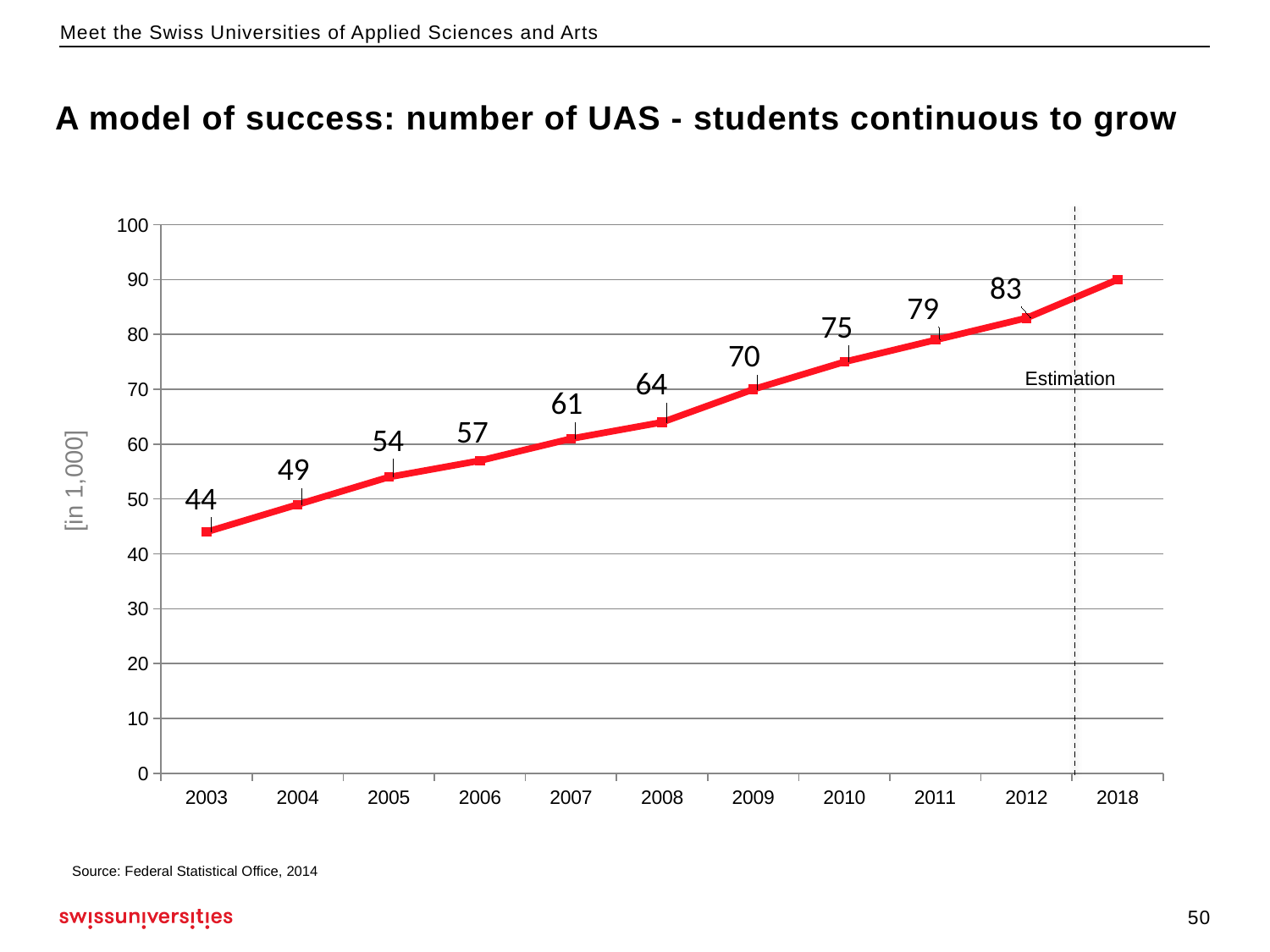
What is the value for 2009? 70 What is the value for 2012? 83 What is the difference between the values for 2012 and 2003? 39 What is the y-axis label? [in 1,000] Do the values rise or fall from 2003 to 2012? rise Is the value for 2018 greater or less than 80? greater What kind of chart is this? line chart What is the value for 2003? 44 How many years are shown on the x axis? 11 What is the difference between the values for 2008 and 2007? 3 Which labelled year has the lowest value? 2003 Which is larger, the value for 2010 or the value for 2006? 2010